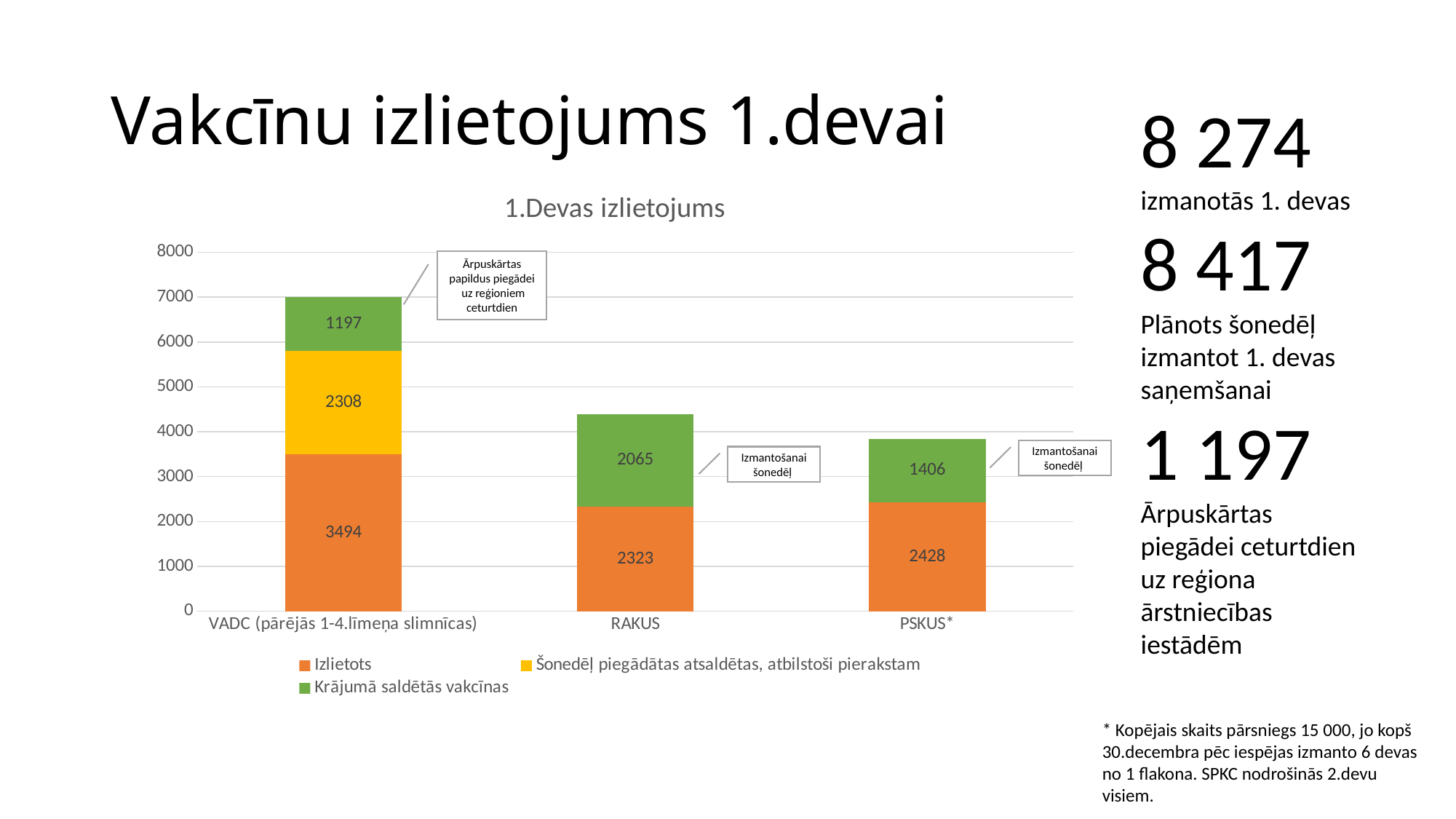
What is the title of the chart? 1.Devas izlietojums What type of chart is shown on the slide? Stacked bar chart What is the total of the stacked bar for RAKUS? 4388 Is the Krājumā saldētās vakcīnas value for RAKUS larger or smaller than that for PSKUS*? larger Which category has the lowest Krājumā saldētās vakcīnas value? VADC (pārējās 1-4.līmeņa slimnīcas) What is the Izlietots value for RAKUS? 2323 What is the Krājumā saldētās vakcīnas value for PSKUS*? 1406 What is the value of Šonedēļ piegādātas atsaldētas, atbilstoši pierakstam for VADC (pārējās 1-4.līmeņa slimnīcas)? 2308 Which category has the highest Izlietots value? VADC (pārējās 1-4.līmeņa slimnīcas) How many series does the chart legend list? 3 How many categories are shown on the x axis of the chart? 3 What is the difference between the Izlietots values for PSKUS* and RAKUS? 105